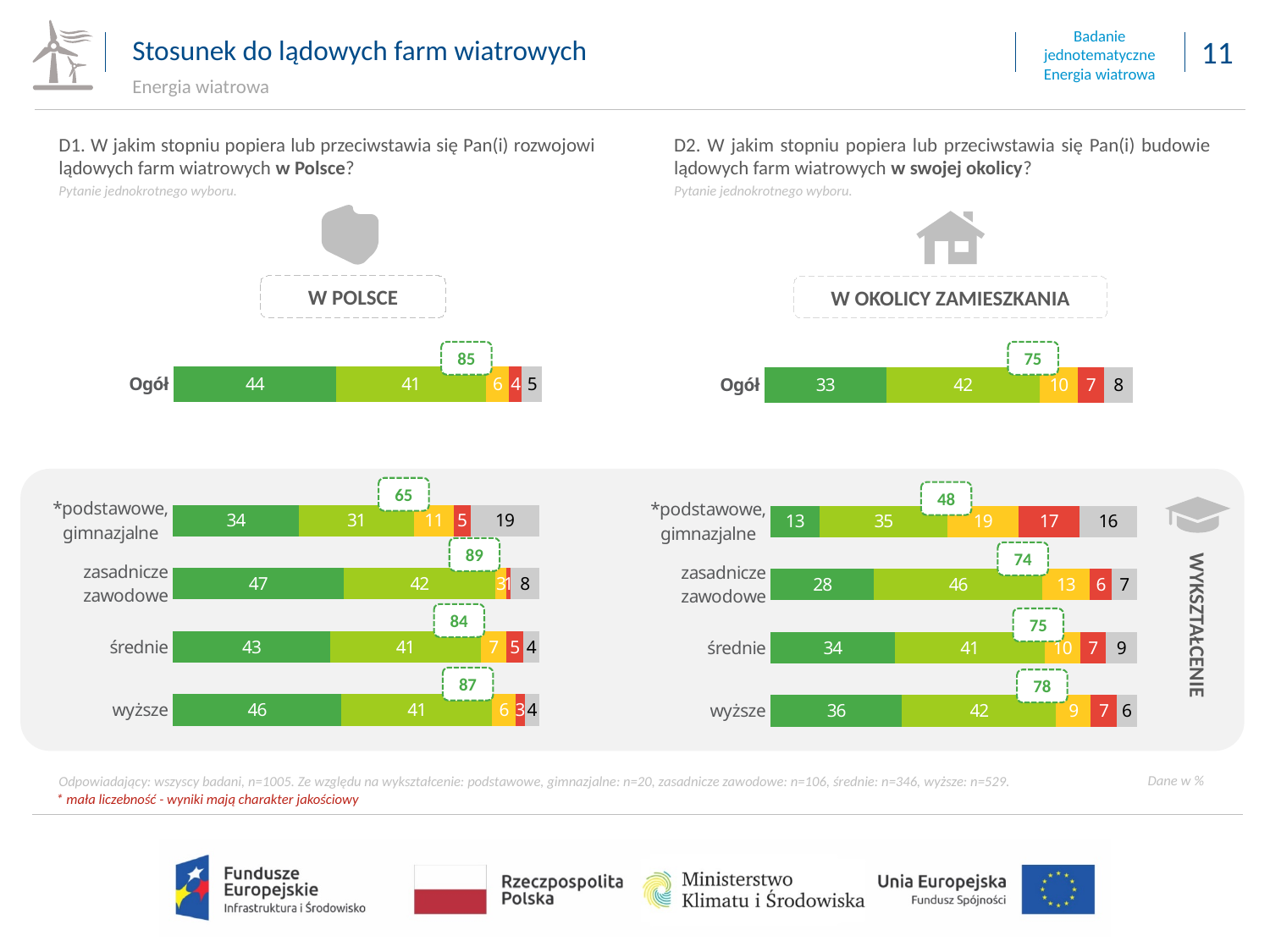
In the 'W OKOLICY ZAMIESZKANIA' education breakdown, which education group has the lowest combined support value in the dashed box? *podstawowe, gimnazjalne In the 'W OKOLICY ZAMIESZKANIA' education breakdown, what is the value of the grey (last) segment for '*podstawowe, gimnazjalne'? 16 In the 'W POLSCE' chart, what combined support value is shown in the dashed box above the 'Ogół' bar? 85 In the 'W POLSCE' chart, what is the value of the first (dark green) segment of the 'Ogół' bar? 44 In the 'W OKOLICY ZAMIESZKANIA' chart, what is the value of the second (light green) segment of the 'Ogół' bar? 42 In the 'W OKOLICY ZAMIESZKANIA' chart, what combined support value is shown in the dashed box above the 'Ogół' bar? 75 In the 'W POLSCE' education breakdown, what is the value of the dark green segment for 'wyższe'? 46 How many education groups are shown in the 'W OKOLICY ZAMIESZKANIA' education breakdown chart? 4 What type of chart is used to show the 'Ogół' results on this slide? Stacked bar chart What is the difference between the combined support values for 'Ogół' in the 'W POLSCE' chart (85) and the 'W OKOLICY ZAMIESZKANIA' chart (75)? 10 Which is larger: the dark green segment for 'średnie' in the 'W POLSCE' chart or in the 'W OKOLICY ZAMIESZKANIA' chart? W POLSCE In the 'W POLSCE' education breakdown, which education group has the highest combined support value in the dashed box? zasadnicze zawodowe